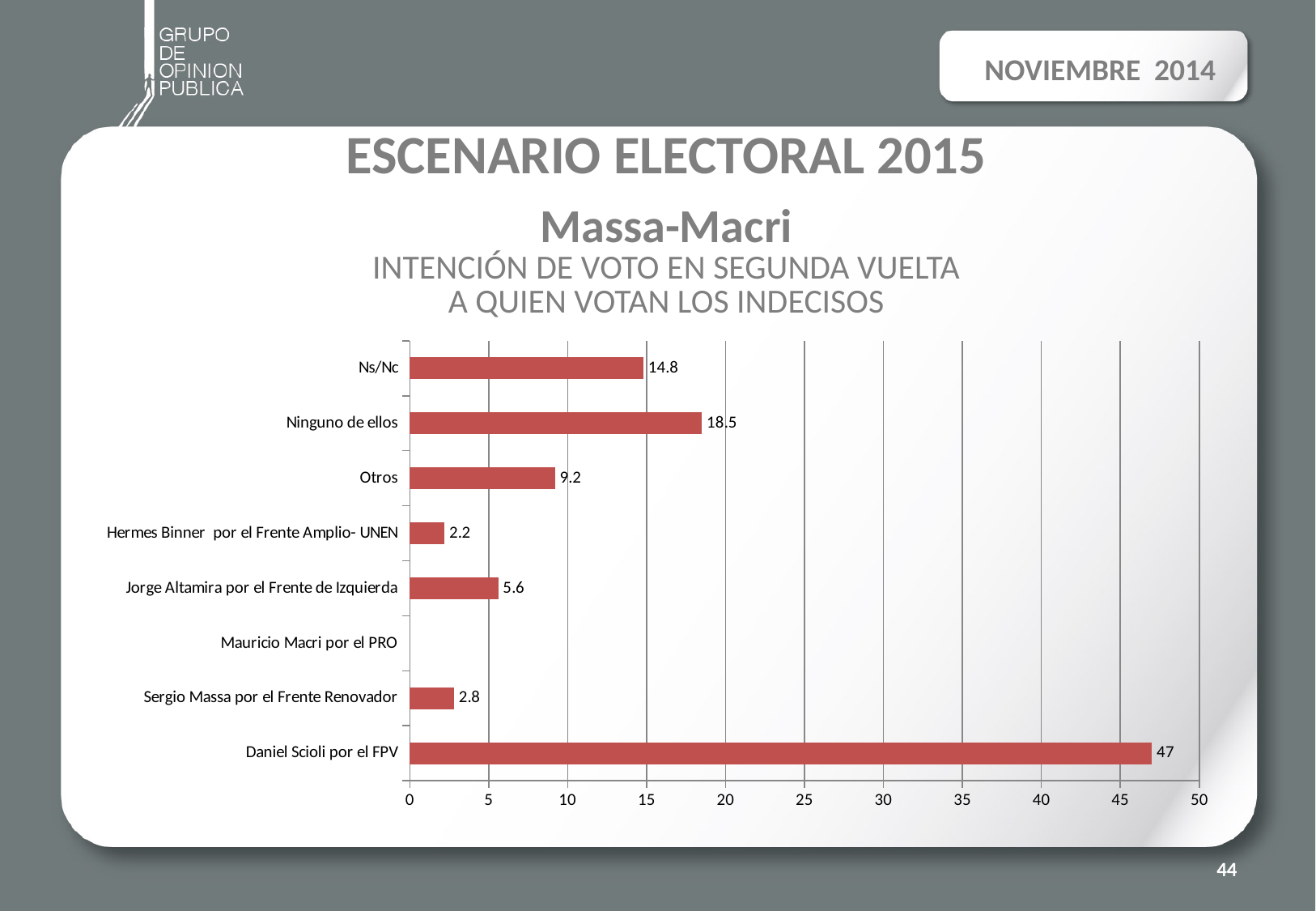
Is the value for Ninguno de ellos greater or less than 20? less Which is larger, the value for Otros or the value for Jorge Altamira por el Frente de Izquierda? Otros What is the difference between the values for Ninguno de ellos and Ns/Nc? 3.7 What is the difference between the values for Daniel Scioli por el FPV and Otros? 37.8 How many categories are shown on the chart? 8 What kind of chart is shown on the slide? bar chart What is the value for Ninguno de ellos? 18.5 What is the value for Daniel Scioli por el FPV? 47 What is the value for Ns/Nc? 14.8 What is the value for Sergio Massa por el Frente Renovador? 2.8 Which category has the highest value? Daniel Scioli por el FPV What is the value for Jorge Altamira por el Frente de Izquierda? 5.6